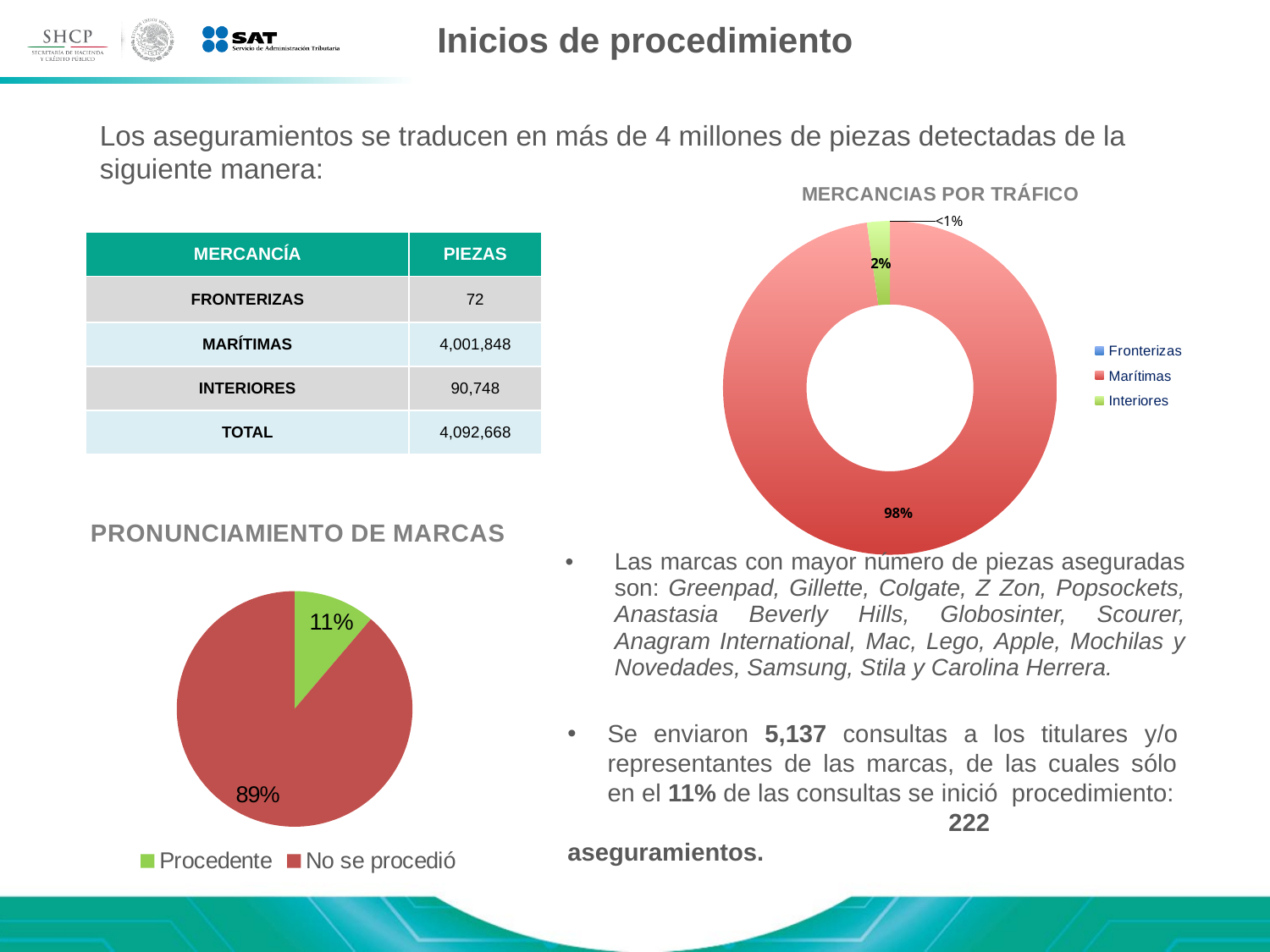
In the MERCANCIAS POR TRÁFICO chart, which category has the largest share? Marítimas In the MERCANCIAS POR TRÁFICO chart, which category has the smallest share? Fronterizas What kind of chart is PRONUNCIAMIENTO DE MARCAS? Pie chart In the MERCANCIAS POR TRÁFICO chart, what label is shown for the Fronterizas slice? <1% In the MERCANCIAS POR TRÁFICO chart, what share is labelled for Marítimas? 98% In the MERCANCIAS POR TRÁFICO chart, what share is labelled for Interiores? 2% In the PRONUNCIAMIENTO DE MARCAS chart, what is the difference in percentage points between No se procedió and Procedente? 78 percentage points What kind of chart is MERCANCIAS POR TRÁFICO? Doughnut chart In the PRONUNCIAMIENTO DE MARCAS chart, what share is Procedente? 11% How many categories does the legend of the MERCANCIAS POR TRÁFICO chart list? 3 In the PRONUNCIAMIENTO DE MARCAS chart, which category is larger, Procedente or No se procedió? No se procedió In the PRONUNCIAMIENTO DE MARCAS chart, what share is No se procedió? 89%